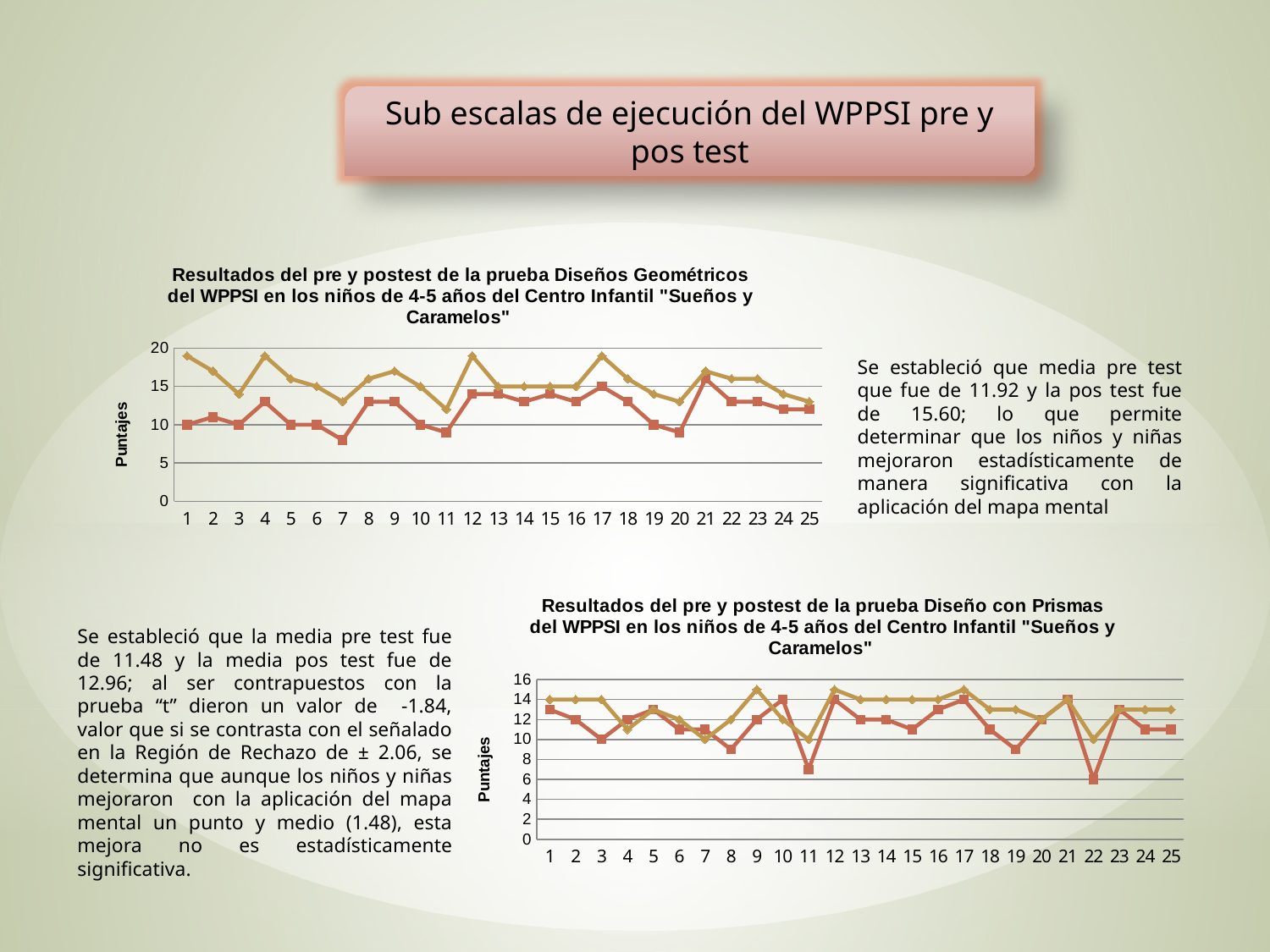
In the top chart (Diseños Geométricos), at point 1, which line has the higher value: the diamond-marker line or the square-marker line? The diamond-marker line In the top chart (Diseños Geométricos), is the value of the diamond-marker line at point 1 greater or less than 15? greater In the top chart (Diseños Geométricos), how many data series (lines) are plotted? 2 In the bottom chart (Diseño con Prismas), how many points are labelled along the x axis? 25 What is the y-axis label of the bottom chart (Diseño con Prismas)? Puntajes What type of chart is the top chart titled "Resultados del pre y postest de la prueba Diseños Geométricos"? Line chart In the bottom chart (Diseño con Prismas), is the value of the diamond-marker line at point 22 greater or less than 12? less In the bottom chart (Diseño con Prismas), at which x-axis point does the square-marker line reach its lowest value? 22 In the top chart (Diseños Geométricos), is the value of the square-marker line at point 7 greater or less than 10? less In the top chart (Diseños Geométricos), how many points are labelled along the x axis? 25 What type of chart is the bottom chart titled "Resultados del pre y postest de la prueba Diseño con Prismas"? Line chart